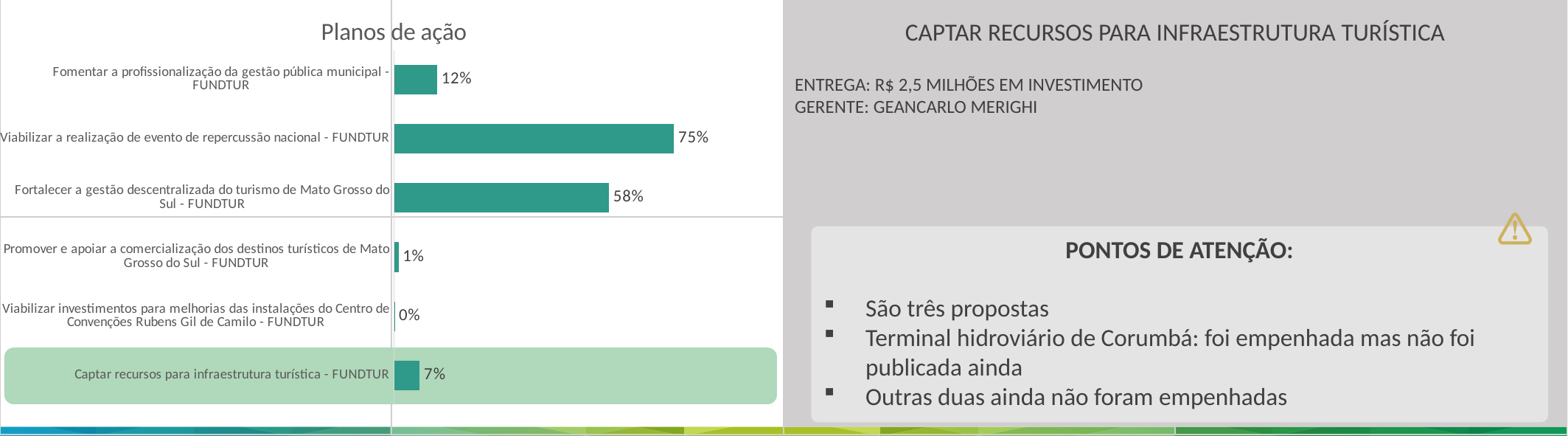
Which is larger: the value for "Fomentar a profissionalização da gestão pública municipal - FUNDTUR" or the value for "Captar recursos para infraestrutura turística - FUNDTUR"? Fomentar a profissionalização da gestão pública municipal - FUNDTUR What is the value for "Fomentar a profissionalização da gestão pública municipal - FUNDTUR"? 12% What is the value for "Promover e apoiar a comercialização dos destinos turísticos de Mato Grosso do Sul - FUNDTUR"? 1% What is the value for "Viabilizar investimentos para melhorias das instalações do Centro de Convenções Rubens Gil de Camilo - FUNDTUR"? 0% How many categories are plotted in the "Planos de ação" chart? 6 What is the difference between the values for "Viabilizar a realização de evento de repercussão nacional - FUNDTUR" and "Fortalecer a gestão descentralizada do turismo de Mato Grosso do Sul - FUNDTUR"? 17% Which category has the highest value in the "Planos de ação" chart? Viabilizar a realização de evento de repercussão nacional - FUNDTUR What is the value for "Viabilizar a realização de evento de repercussão nacional - FUNDTUR"? 75% Which category has the lowest value in the "Planos de ação" chart? Viabilizar investimentos para melhorias das instalações do Centro de Convenções Rubens Gil de Camilo - FUNDTUR What is the title of the chart on the slide? Planos de ação What kind of chart is shown under the title "Planos de ação"? bar chart What is the value for "Captar recursos para infraestrutura turística - FUNDTUR"? 7%